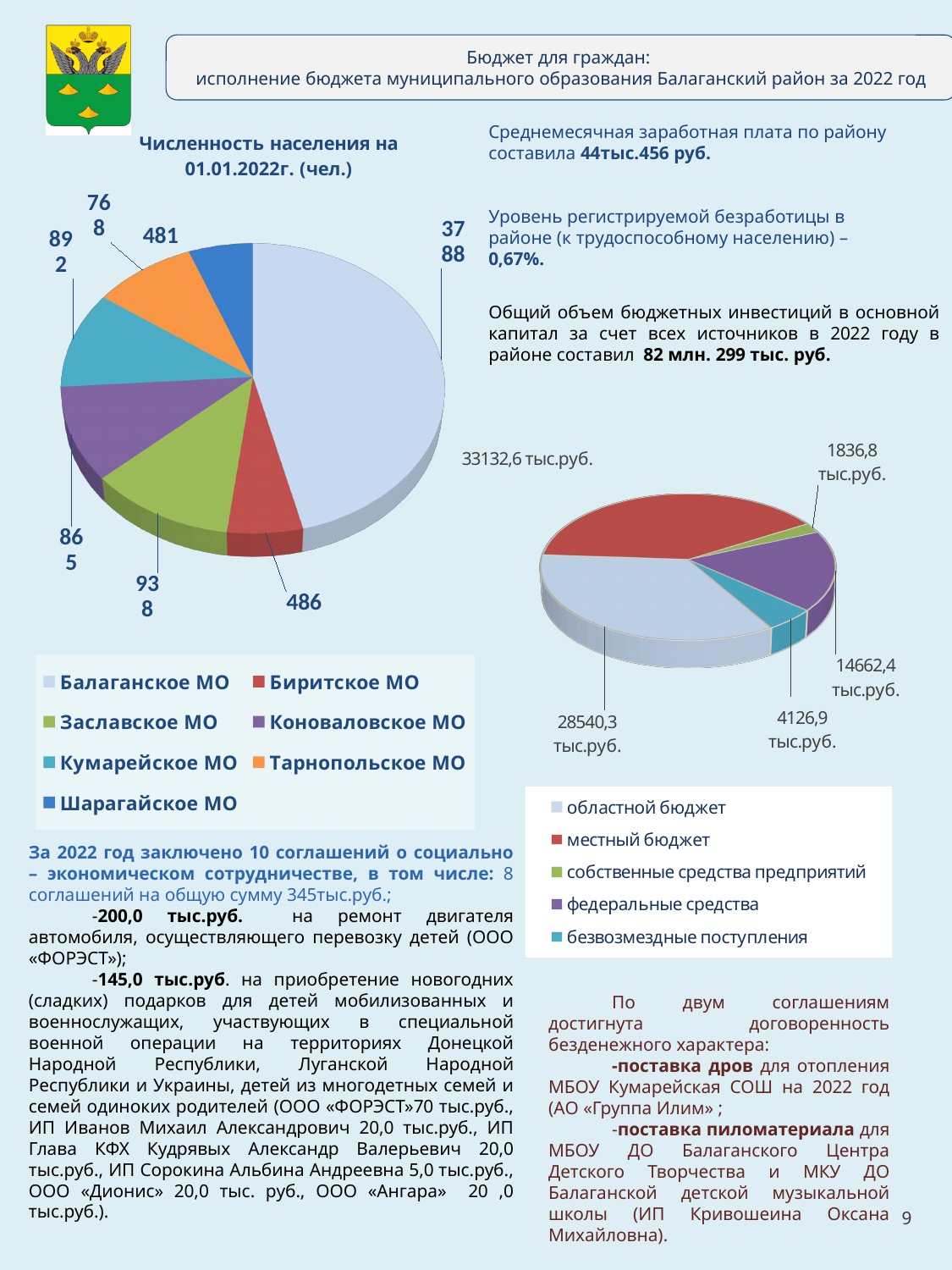
In the right-hand pie chart of budget investment sources, what is the value for безвозмездные поступления? 4126,9 тыс.руб. In the 'Численность населения на 01.01.2022г. (чел.)' chart, which colour represents Тарнопольское МО? orange In the 'Численность населения на 01.01.2022г. (чел.)' chart, what is the value for Шарагайское МО? 481 In the right-hand pie chart of budget investment sources, what is the value for федеральные средства? 14662,4 тыс.руб. In the right-hand pie chart of budget investment sources, which is larger: федеральные средства or безвозмездные поступления? федеральные средства In the 'Численность населения на 01.01.2022г. (чел.)' chart, how many categories does the legend list? 7 In the right-hand pie chart of budget investment sources, what is the value for собственные средства предприятий? 1836,8 тыс.руб. In the 'Численность населения на 01.01.2022г. (чел.)' chart, which municipality has the largest population? Балаганское МО In the 'Численность населения на 01.01.2022г. (чел.)' chart, what is the value for Биритское МО? 486 What kind of chart is the 'Численность населения на 01.01.2022г. (чел.)' chart? pie chart In the right-hand pie chart of budget investment sources, how many categories does the legend list? 5 What kind of chart is the chart on the right side of the slide showing budget investment sources? pie chart